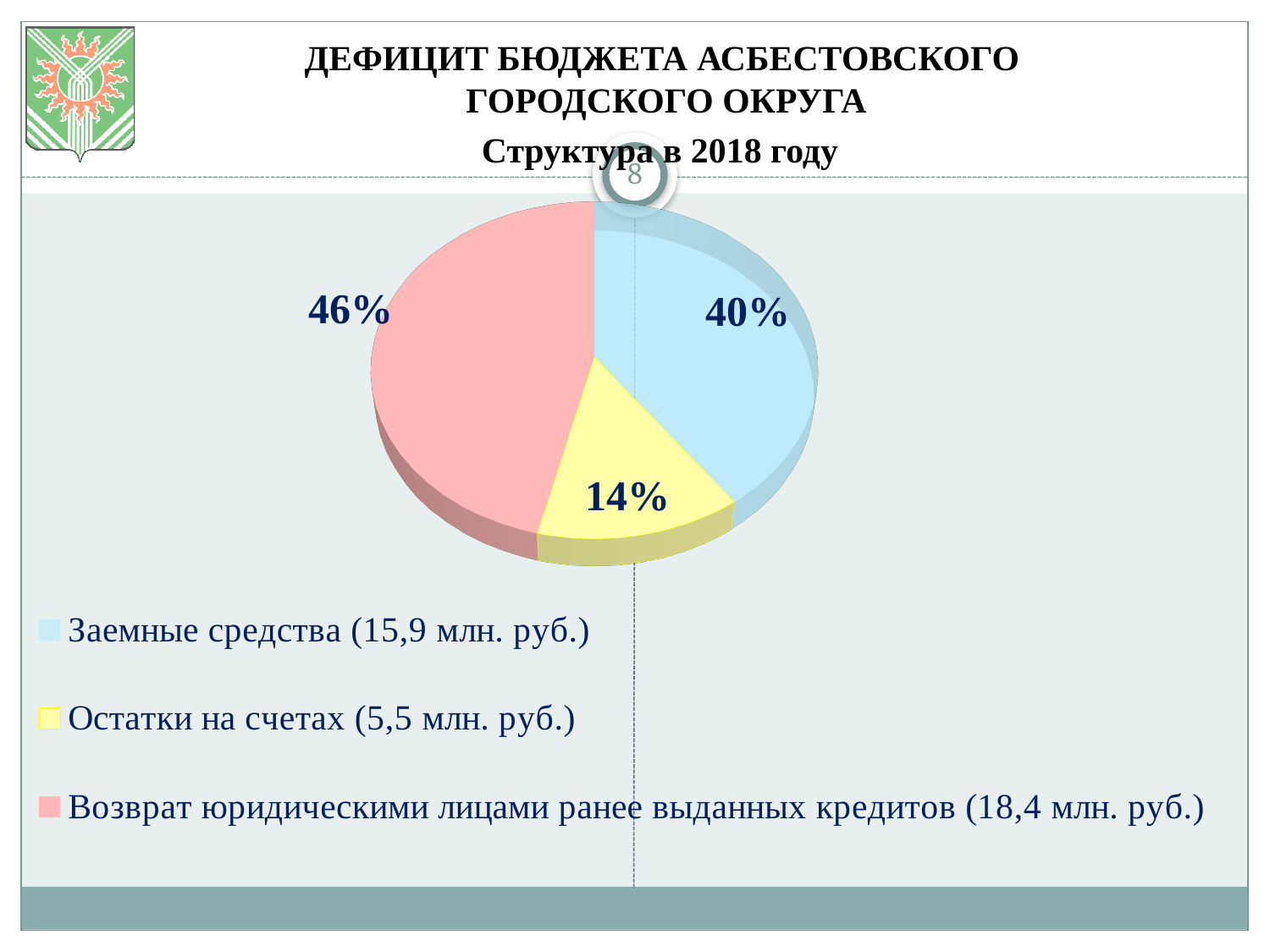
What amount in million rubles is given in the legend for "Остатки на счетах"? 5,5 млн. руб. What share of the pie does "Заемные средства" take? 40% Which category has the largest share of the pie? Возврат юридическими лицами ранее выданных кредитов How many entries does the legend list? 3 What share of the pie does "Остатки на счетах" take? 14% What colour is the slice for "Заемные средства"? light blue What share of the pie does "Возврат юридическими лицами ранее выданных кредитов" take? 46% Which category has the smallest share of the pie? Остатки на счетах Which is larger: the share of "Заемные средства" or the share of "Остатки на счетах"? Заемные средства How many slices does the pie chart have? 3 What is the difference in percentage points between the shares of "Возврат юридическими лицами ранее выданных кредитов" and "Заемные средства"? 6% What kind of chart is shown on the slide? pie chart